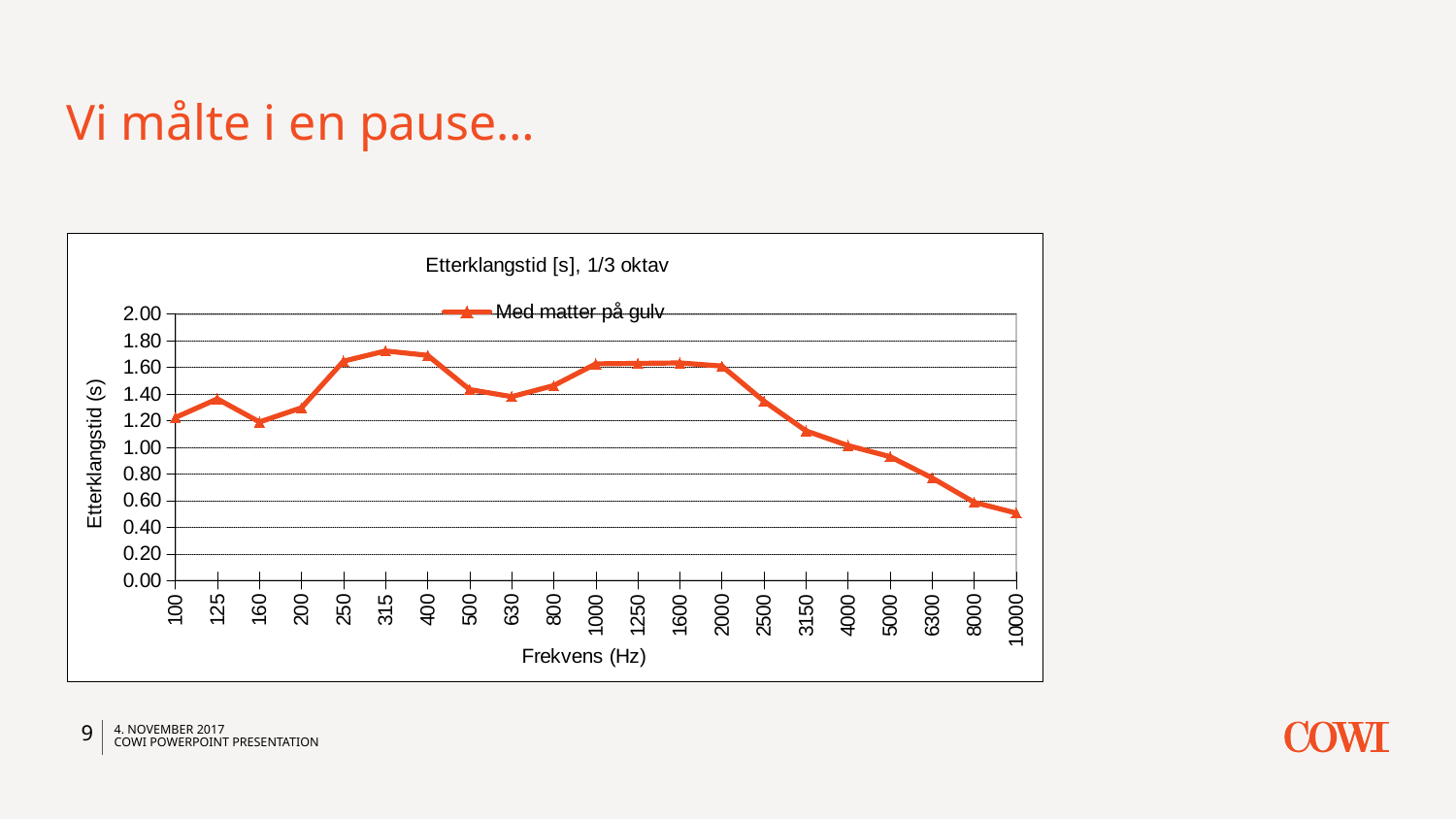
Do the values rise or fall along the x axis from 2000 Hz to 10000 Hz? fall What kind of chart is shown on the slide? Line chart Which has the larger reverberation time, 250 Hz or 630 Hz? 250 Hz Is the value at 2500 Hz greater or less than 1.20? greater What is the title of the chart? Etterklangstid [s], 1/3 oktav Is the value at 315 Hz greater or less than 1.60? greater What is the name of the series shown in the legend? Med matter på gulv At which frequency is the reverberation time lowest? 10000 Is the value at 5000 Hz greater or less than 1.00? less How many frequency categories are plotted along the x axis? 21 How many series does the legend list? 1